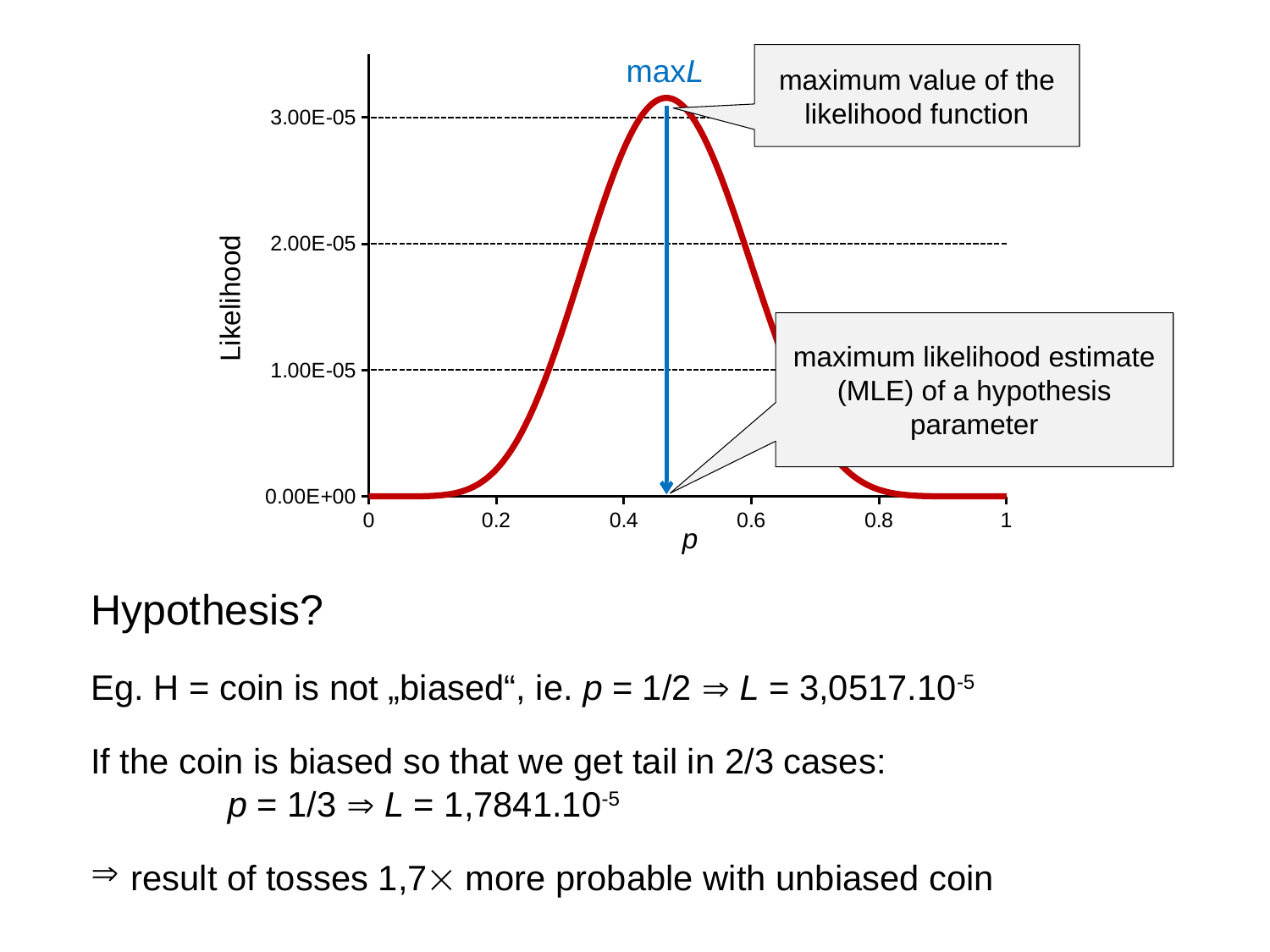
What kind of chart is shown on the slide? line chart Does the likelihood curve rise or fall as p increases from 0 to 0.4? rise Is the likelihood value at p = 0.2 greater or less than 1.00E-05? less How many labelled tick marks are on the x axis of the chart? 6 What is the label of the y axis of the chart? Likelihood Is the maximum value of the likelihood curve greater or less than 3.00E-05? greater What is the label of the x axis of the chart? p Does the likelihood curve rise or fall as p increases from 0.6 to 1? fall What is the highest value labelled on the y axis of the chart? 3.00E-05 Is the likelihood value at p = 0.8 greater or less than 1.00E-05? less Between which two labelled x-axis ticks does the peak of the likelihood curve lie? 0.4 and 0.6